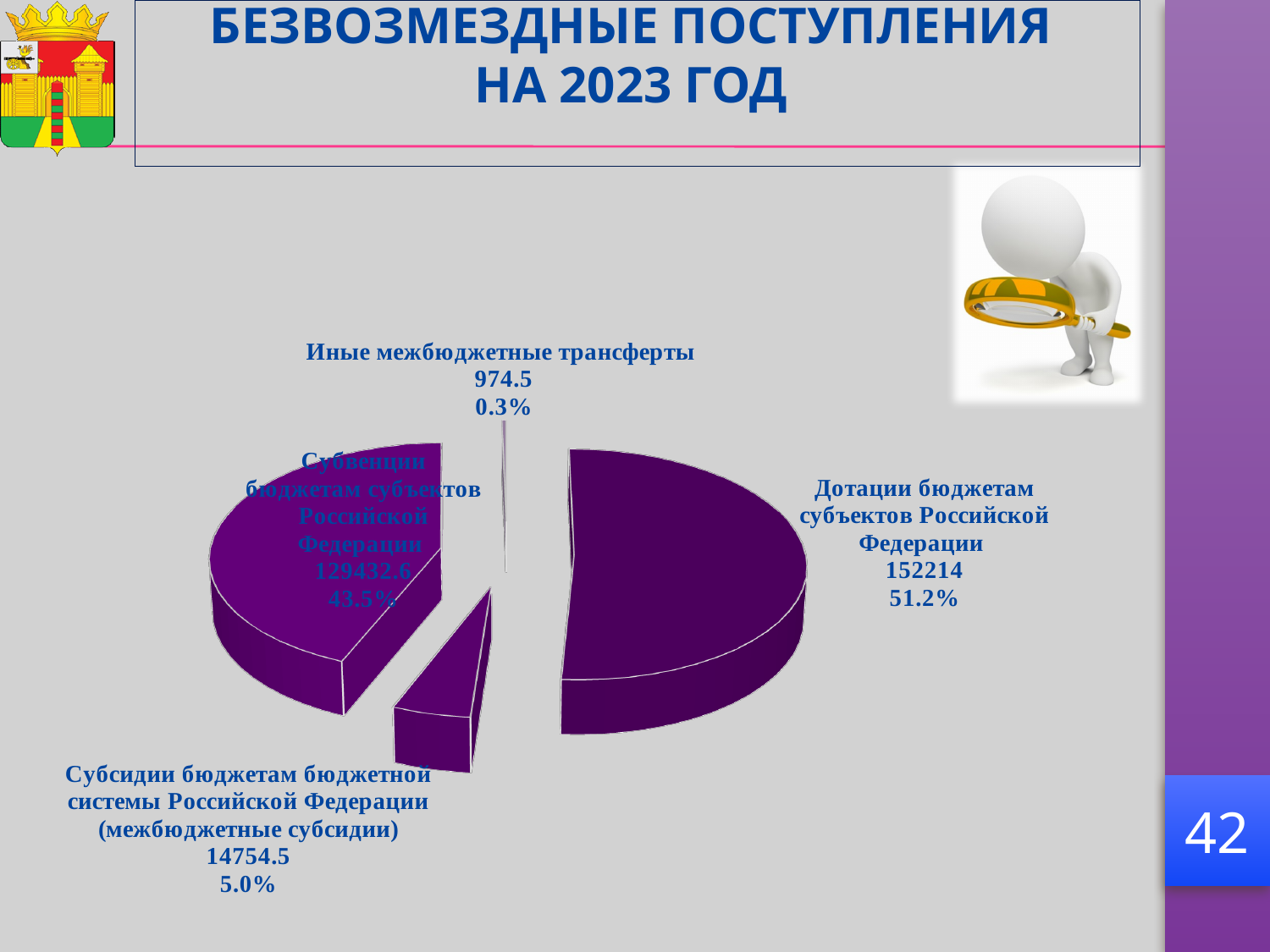
What is the title of the slide containing the chart? БЕЗВОЗМЕЗДНЫЕ ПОСТУПЛЕНИЯ НА 2023 ГОД Which category has the largest slice of the pie? Дотации бюджетам субъектов Российской Федерации Which category has the smallest slice of the pie? Иные межбюджетные трансферты What kind of chart is shown on the slide? pie chart What is the value for Субсидии бюджетам бюджетной системы Российской Федерации (межбюджетные субсидии)? 14754.5 What share of the pie is Иные межбюджетные трансферты? 0.3% How many slices does the pie chart have? 4 Which is larger: Субсидии бюджетам бюджетной системы Российской Федерации (межбюджетные субсидии) or Иные межбюджетные трансферты? Субсидии бюджетам бюджетной системы Российской Федерации (межбюджетные субсидии) What share of the pie is Дотации бюджетам субъектов Российской Федерации? 51.2% What is the value for Дотации бюджетам субъектов Российской Федерации? 152214 What is the value for Иные межбюджетные трансферты? 974.5 What share of the pie is Субвенции бюджетам субъектов Российской Федерации? 43.5%